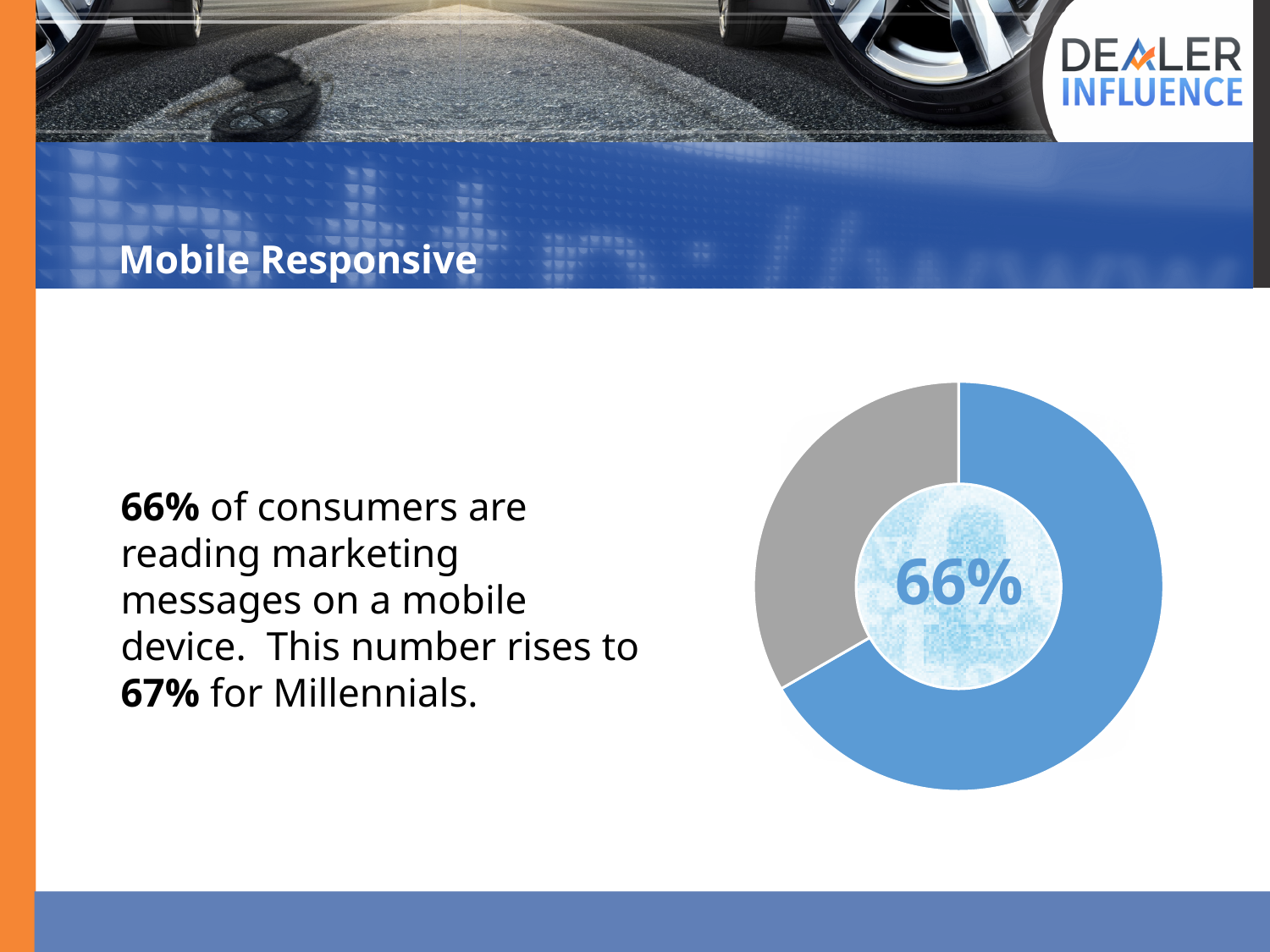
According to the slide text, what does the percentage rise to for Millennials? 67% According to the slide text, what percentage of consumers are reading marketing messages on a mobile device? 66% What percentage is printed in the centre of the donut chart? 66% What share of the donut chart does the blue slice represent? 66% Is the grey slice of the donut chart greater or less than 50% of the whole? less What colour is the larger slice of the donut chart? Blue How many slices does the donut chart have? 2 Is the blue slice of the donut chart greater or less than 50% of the whole? greater Which slice of the donut chart is larger, the blue one or the grey one? The blue one What is the title of the slide containing the donut chart? Mobile Responsive What kind of chart is shown on the slide? Donut (pie) chart